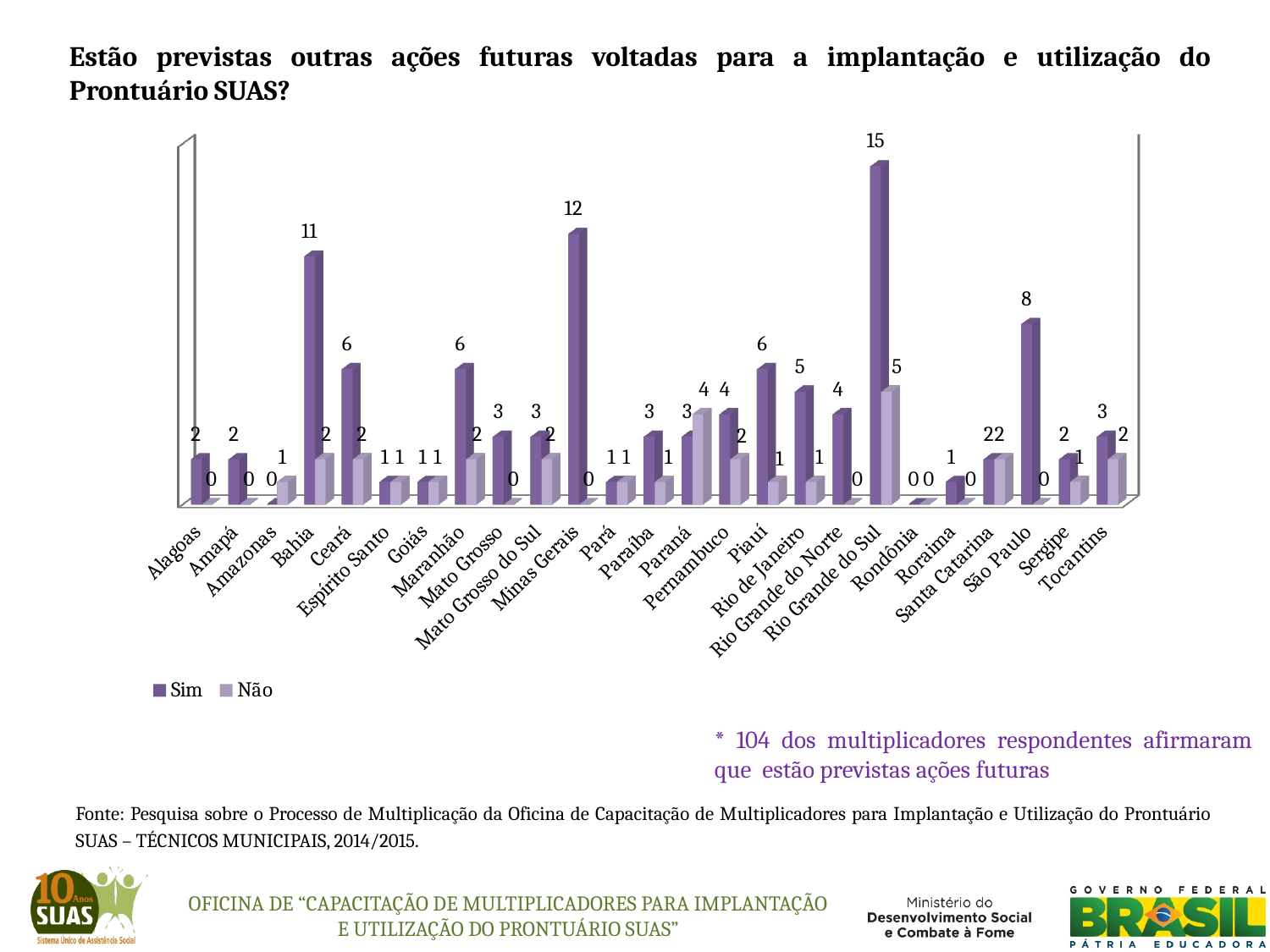
What kind of chart is shown on the slide? Bar chart How many states are shown on the x axis? 25 How many series does the legend list? 2 What is the 'Sim' value for Rio Grande do Sul? 15 What are the two legend entries of the chart? Sim and Não What is the total of the 'Sim' and 'Não' values for Rio Grande do Sul? 20 Which state has the highest 'Não' value? Rio Grande do Sul What is the difference between the 'Sim' values for Bahia and São Paulo? 3 What is the 'Sim' value for Minas Gerais? 12 Which state has the highest 'Sim' value? Rio Grande do Sul What is the 'Não' value for Paraná? 4 Which is larger, the 'Sim' value for Ceará or the 'Sim' value for Rio de Janeiro? Ceará